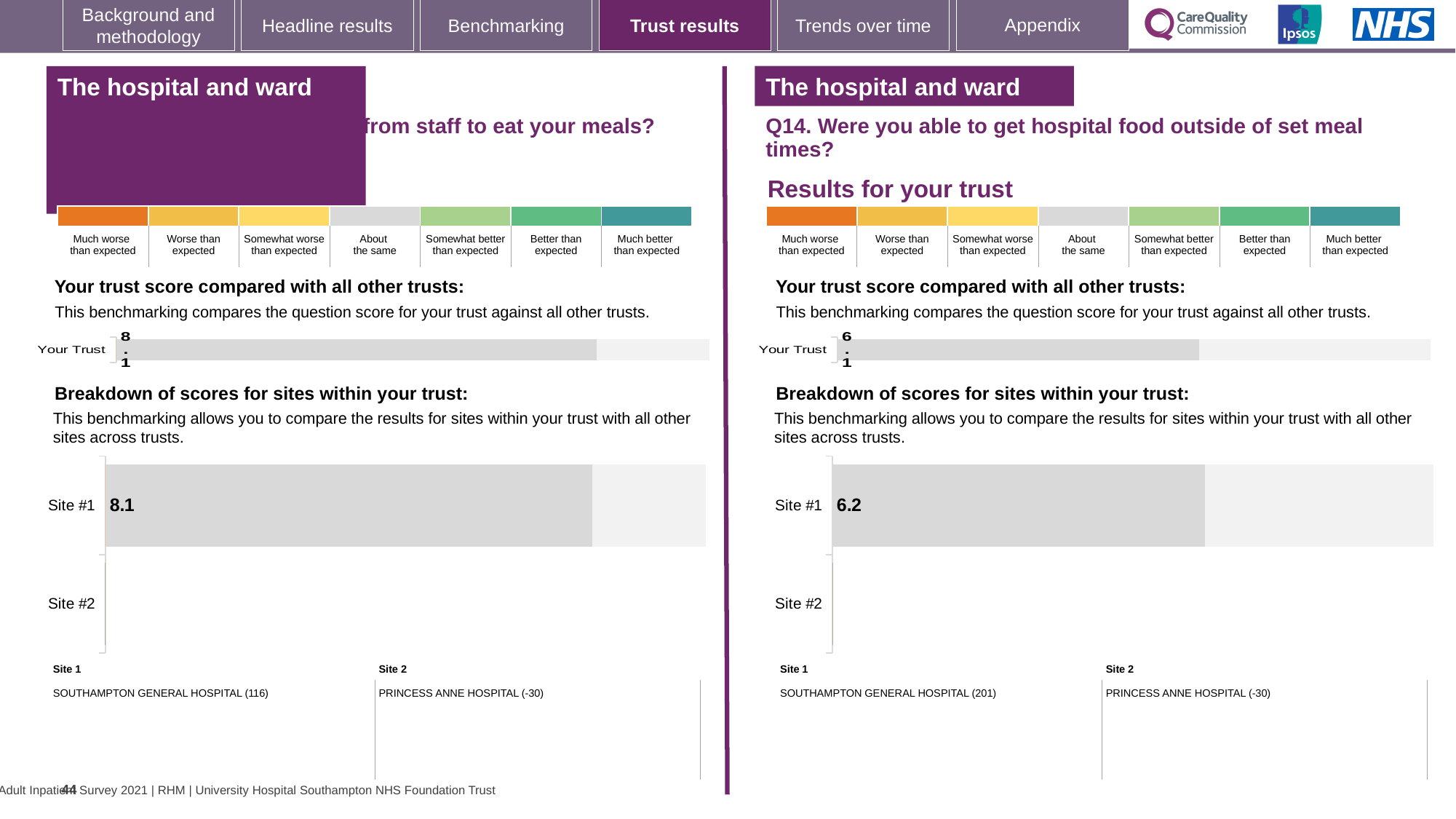
How many sites are listed in the breakdown of scores for sites chart on the right-hand panel (Q14)? 2 On the left-hand panel, what is the score shown for Site #1 in the breakdown of scores for sites chart? 8.1 On the left-hand panel, what is the score shown for 'Your Trust' in the trust comparison chart? 8.1 On the right-hand panel (Q14), which site has a visible bar in the breakdown of scores for sites chart? Site #1 On the right-hand panel (Q14), what is the score shown for Site #1 in the breakdown of scores for sites chart? 6.2 On the left-hand panel, is the Site #1 score greater or less than the Site #1 score on the right-hand panel (Q14)? greater Which panel shows the higher 'Your Trust' score, the left-hand panel or the right-hand panel (Q14)? the left-hand panel On the right-hand panel (Q14), what is the difference between the Site #1 score and the 'Your Trust' score? 0.1 What is the difference between the Site #1 score on the left-hand panel and the Site #1 score on the right-hand panel (Q14)? 1.9 On the right-hand panel (Q14), which hospital is listed as Site 1 below the breakdown chart? SOUTHAMPTON GENERAL HOSPITAL (201) What type of chart is used to show the breakdown of scores for sites within your trust on the left-hand panel? bar chart On the right-hand panel (Q14), what is the score shown for 'Your Trust' in the trust comparison chart? 6.1